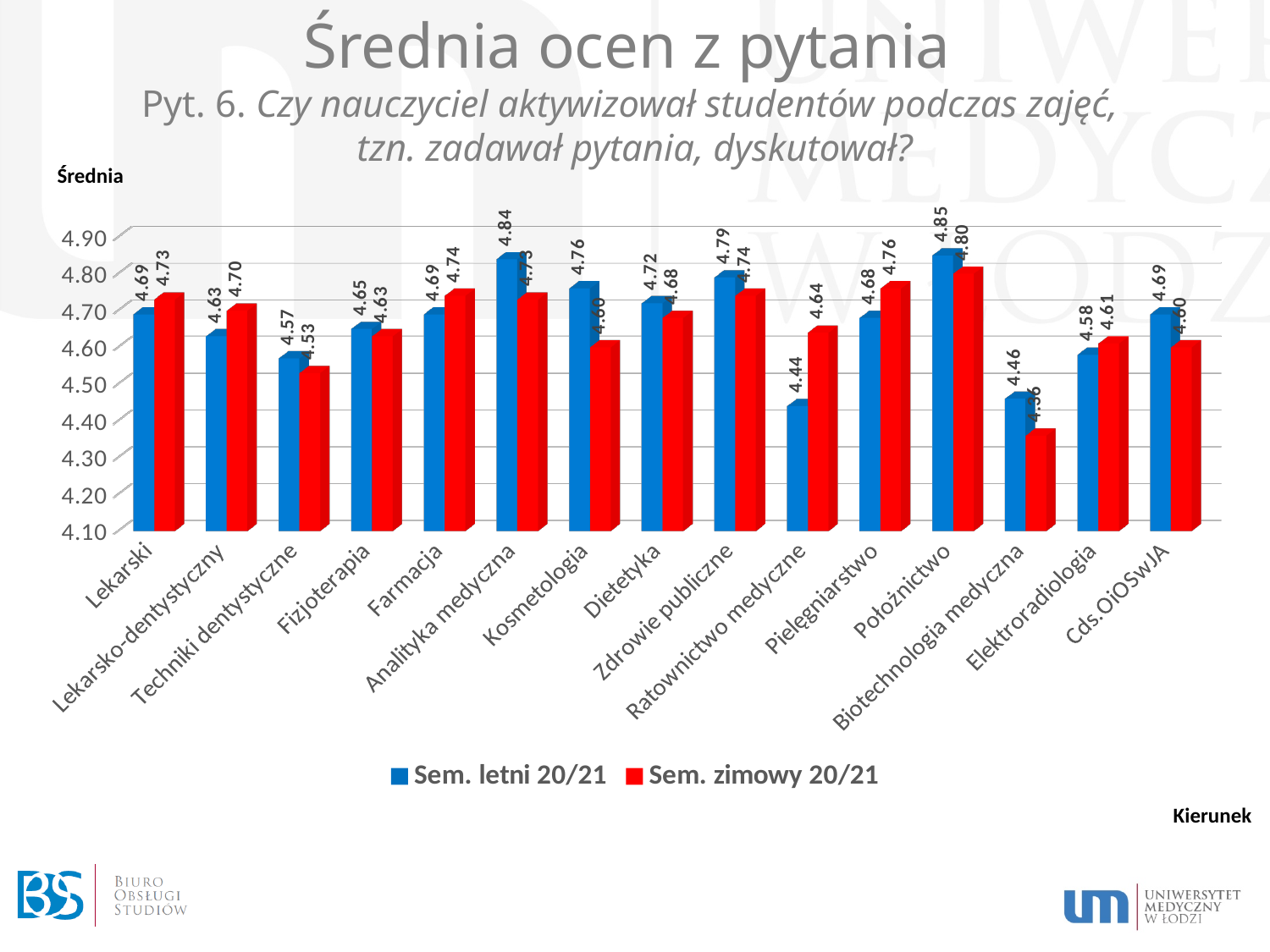
Which category has the lowest value in the Sem. letni 20/21 series? Ratownictwo medyczne How many categories (kierunki) are shown on the x axis? 15 What is the value for Ratownictwo medyczne in the Sem. zimowy 20/21 series? 4.64 For Pielęgniarstwo, which series has the larger value, Sem. letni 20/21 or Sem. zimowy 20/21? Sem. zimowy 20/21 Which category has the lowest value in the Sem. zimowy 20/21 series? Biotechnologia medyczna What is the value for Położnictwo in the Sem. zimowy 20/21 series? 4.80 What is the difference between the Sem. zimowy 20/21 and Sem. letni 20/21 values for Ratownictwo medyczne? 0.20 What is the value for Lekarski in the Sem. letni 20/21 series? 4.69 How many series does the legend list? 2 Which category has the highest value in the Sem. letni 20/21 series? Położnictwo Is the Sem. zimowy 20/21 value for Biotechnologia medyczna greater or less than 4.40? less What is the difference between the Sem. letni 20/21 and Sem. zimowy 20/21 values for Techniki dentystyczne? 0.04